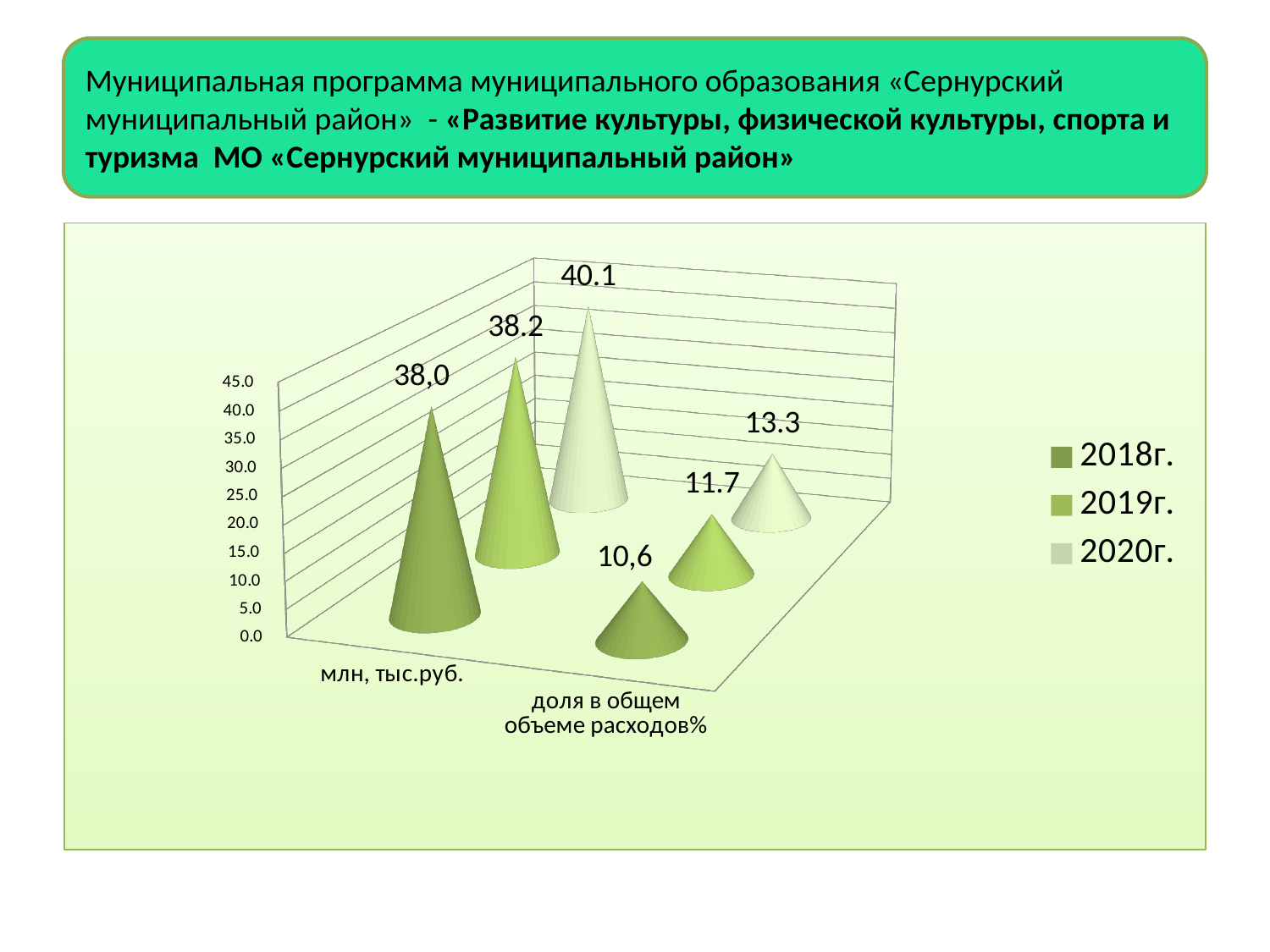
Which is larger: the 2019г. value or the 2020г. value in the category «доля в общем объеме расходов%»? 2020г. What is the value for 2019г. in the category «млн, тыс.руб.»? 38.2 What is the value for 2020г. in the category «доля в общем объеме расходов%»? 13.3 What is the difference between the 2020г. and 2019г. values in the category «млн, тыс.руб.»? 1.9 What is the value for 2018г. in the category «млн, тыс.руб.»? 38,0 What is the difference between the 2020г. and 2019г. values in the category «доля в общем объеме расходов%»? 1.6 Which year has the highest value in the category «млн, тыс.руб.»? 2020г. How many series does the legend list? 3 Which year has the lowest value in the category «доля в общем объеме расходов%»? 2018г. What kind of chart is shown on the slide? bar chart What is the value for 2018г. in the category «доля в общем объеме расходов%»? 10,6 What is the value for 2020г. in the category «млн, тыс.руб.»? 40.1